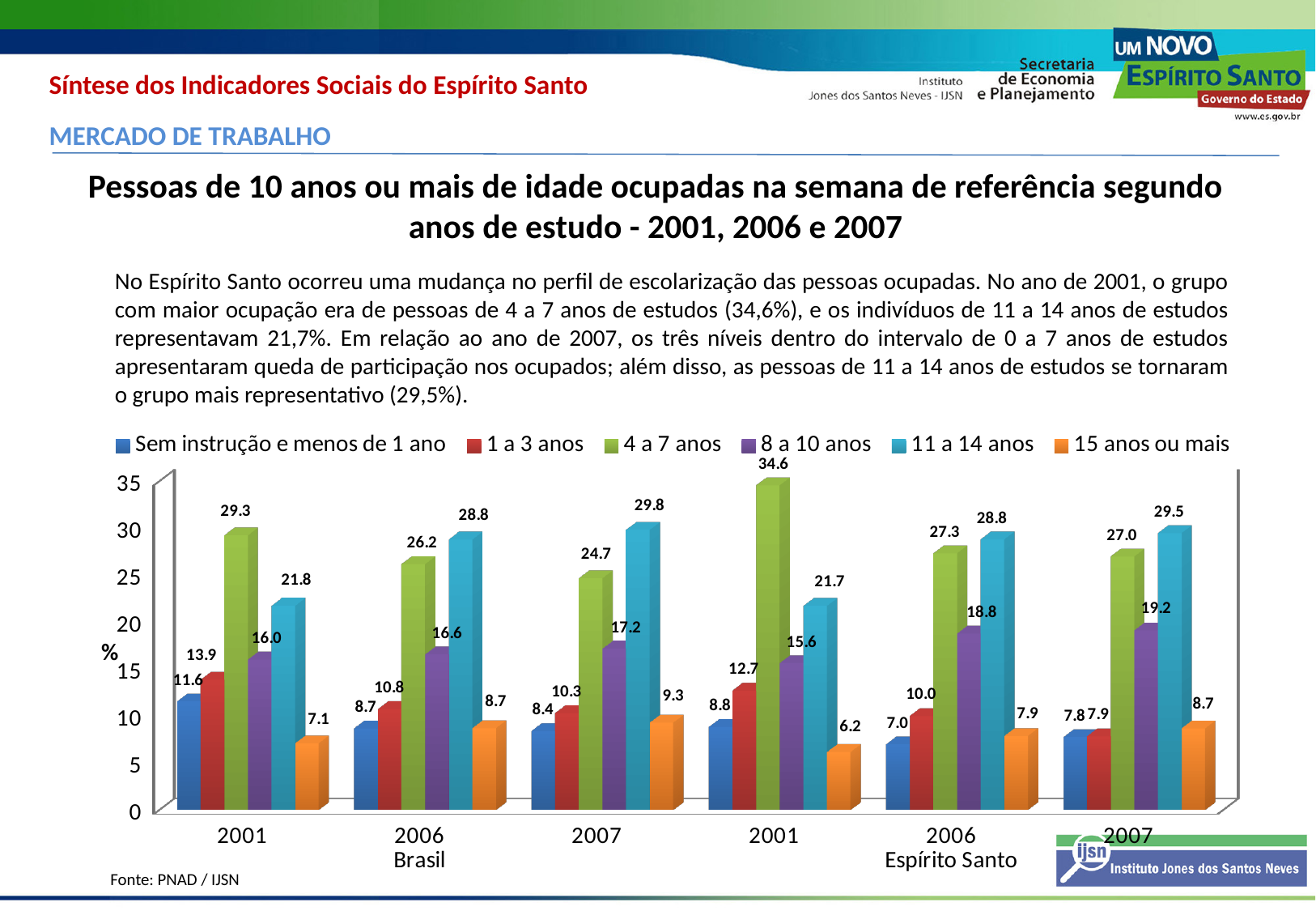
Which series has the lowest value in Espírito Santo in 2001? 15 anos ou mais Which series has the highest value in Espírito Santo in 2007? 11 a 14 anos Which is larger in Brasil in 2006: "4 a 7 anos" or "11 a 14 anos"? 11 a 14 anos Does the "8 a 10 anos" value in Espírito Santo rise or fall from 2001 to 2007? Rise What is the value for "Sem instrução e menos de 1 ano" in Brasil in 2001? 11.6 What is the difference between the "4 a 7 anos" value in Espírito Santo in 2001 and in 2007? 7.6 What kind of chart is shown on the slide? Bar chart How many series does the legend list? 6 What is the value for "4 a 7 anos" in Espírito Santo in 2001? 34.6 What is the value for "15 anos ou mais" in Espírito Santo in 2006? 7.9 What is the value for "11 a 14 anos" in Brasil in 2007? 29.8 How many year groups are shown along the x axis? 6